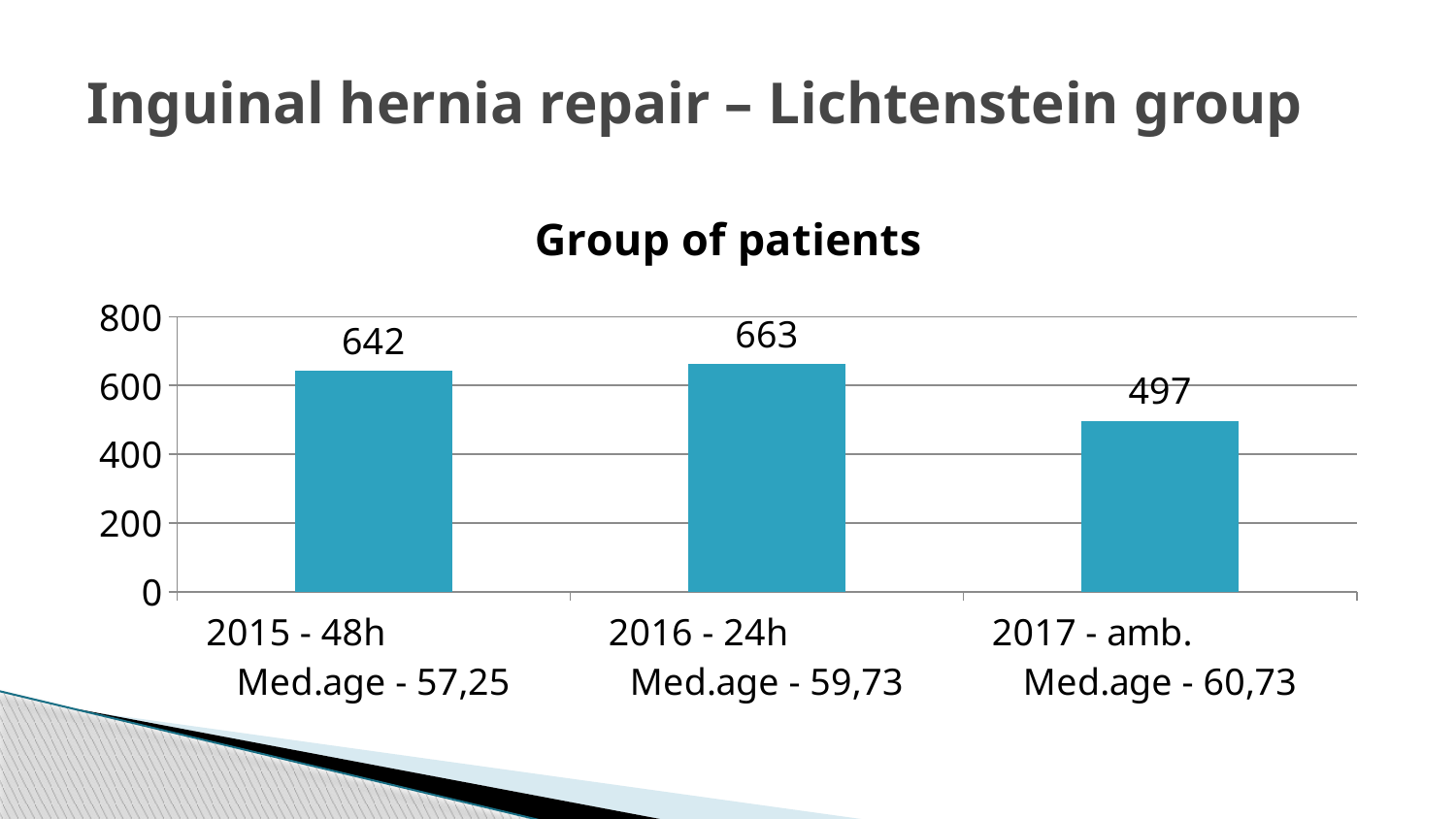
What is the value for the 2016 - 24h group? 663 What is the difference between the values for 2016 - 24h and 2015 - 48h? 21 Which group has the lowest value? 2017 - amb. What is the title of the chart? Group of patients Which group has the highest value? 2016 - 24h What is the value for the 2017 - amb. group? 497 Is the value for 2017 - amb. greater or less than 600? less What is the difference between the values for 2016 - 24h and 2017 - amb.? 166 How many groups are shown in the chart? 3 What is the value for the 2015 - 48h group? 642 Which is larger, the value for 2015 - 48h or the value for 2017 - amb.? 2015 - 48h What kind of chart is shown on the slide? bar chart